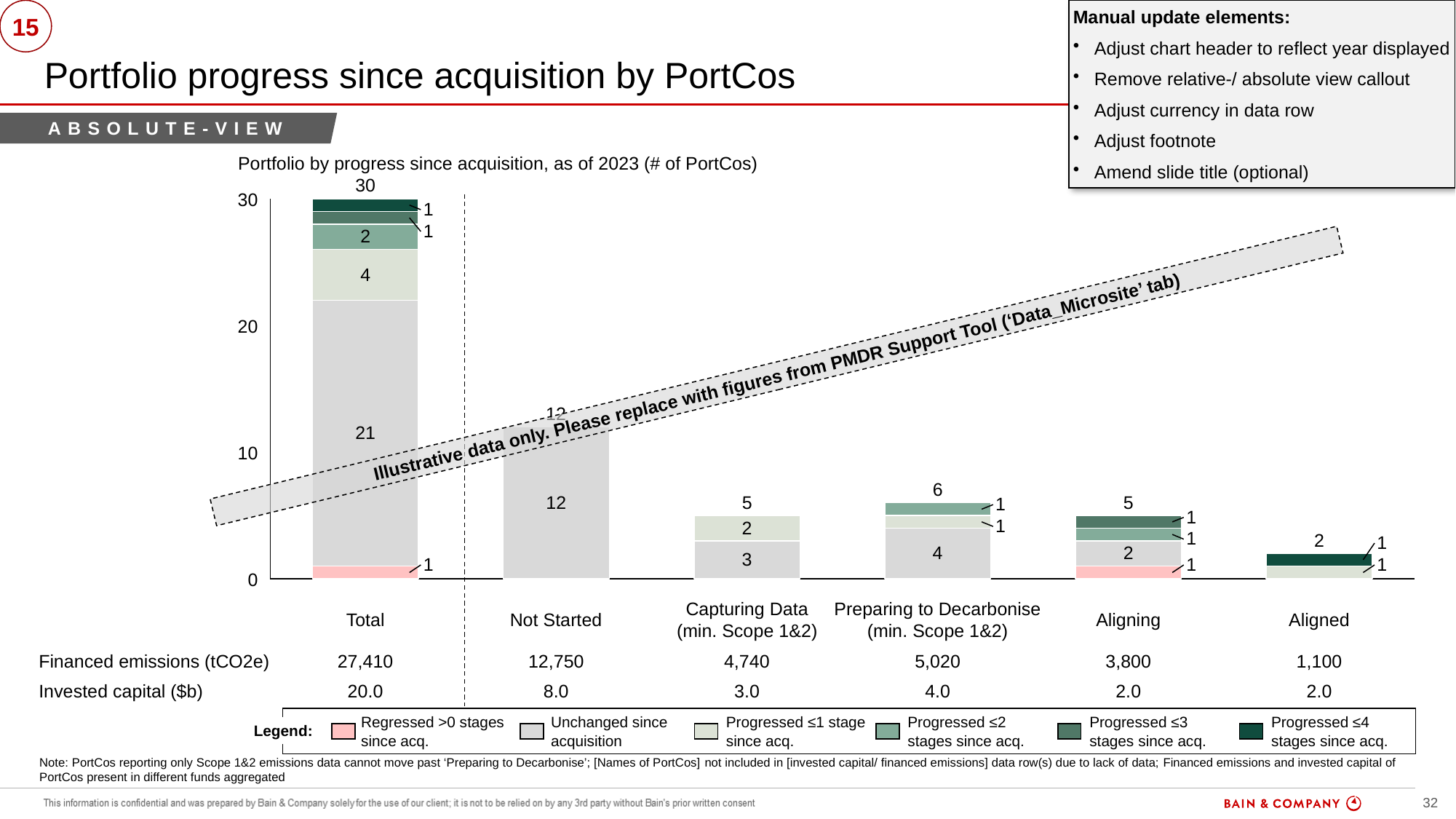
How many PortCos in the Capturing Data (min. Scope 1&2) category have 'Progressed ≤1 stage since acq.'? 2 Excluding the Total bar, which progress category has the highest number of PortCos? Not Started What is the difference between the total PortCos in Preparing to Decarbonise (min. Scope 1&2) and in Aligned? 4 Excluding the Total bar, which progress category has the lowest number of PortCos? Aligned How many PortCos are 'Unchanged since acquisition' in the Total bar? 21 Which has more PortCos in total: Capturing Data (min. Scope 1&2) or Preparing to Decarbonise (min. Scope 1&2)? Preparing to Decarbonise (min. Scope 1&2) What is the total number of PortCos shown for the Total bar? 30 What kind of chart is shown on the slide? Stacked bar chart How many PortCos in the Not Started category are 'Unchanged since acquisition'? 12 What is the invested capital ($b) shown for the Not Started category? 8.0 How many series does the legend list? 6 What is the financed emissions (tCO2e) value shown for the Aligning category? 3,800